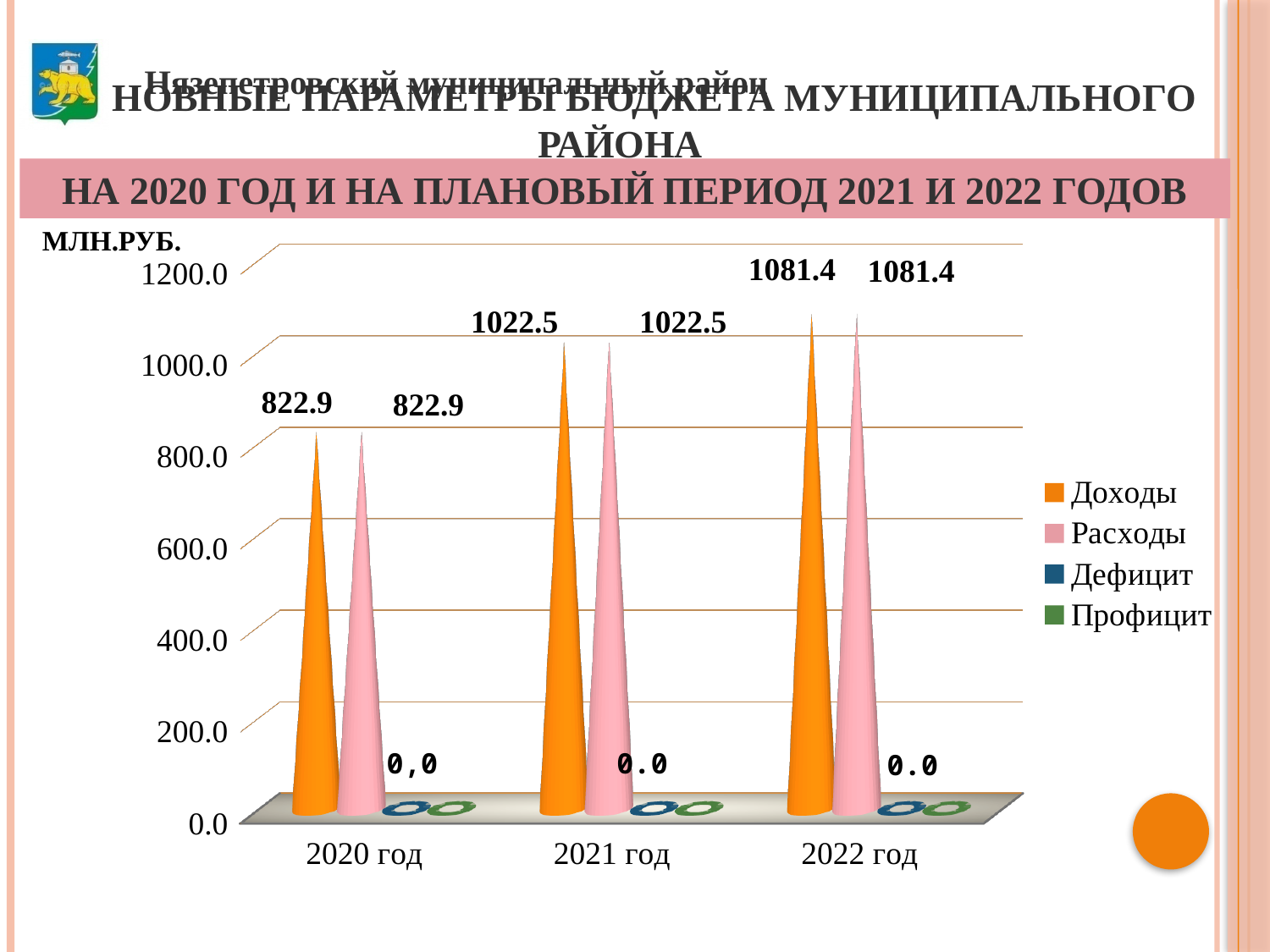
What is the value of Доходы for 2022 год? 1081.4 What unit is shown at the top of the vertical axis? МЛН.РУБ. What is the value of Доходы for 2020 год? 822.9 Do the values for Доходы rise or fall from 2020 год to 2022 год? rise What is the difference between Доходы in 2022 год and Доходы in 2020 год? 258.5 Which year has the lowest value for Расходы? 2020 год What is the value of Расходы for 2021 год? 1022.5 What is the difference between Расходы in 2021 год and Расходы in 2020 год? 199.6 How many year categories are shown on the x axis? 3 Which year has the highest value for Доходы? 2022 год How many series does the legend list? 4 Which is larger: Доходы in 2021 год or Доходы in 2020 год? Доходы in 2021 год